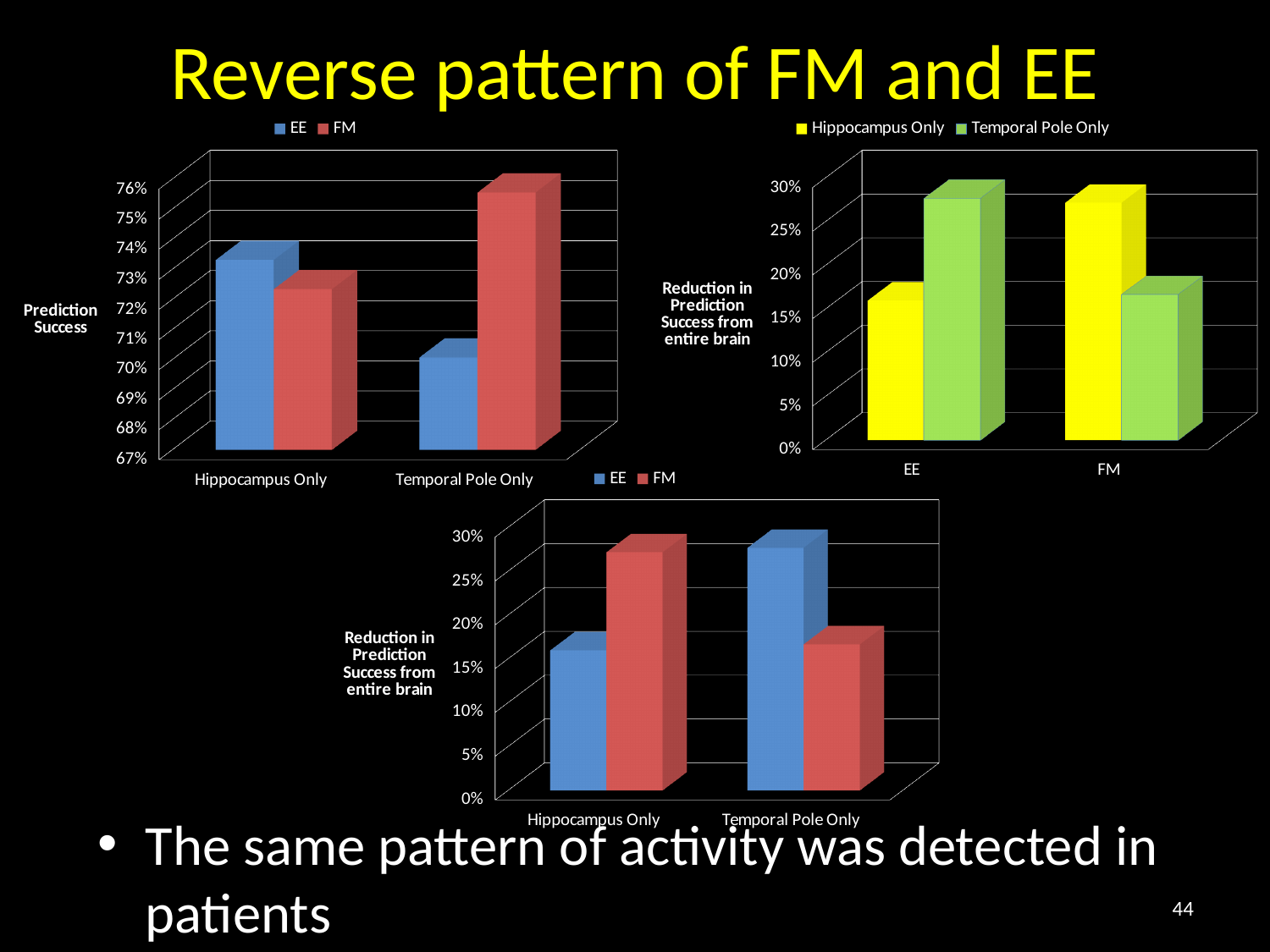
In the top-right chart, for EE, which series has the larger value, Hippocampus Only or Temporal Pole Only? Temporal Pole Only In the top-left chart, is the FM value for Temporal Pole Only greater or less than 74%? greater In the top-left chart, is the EE value for Temporal Pole Only greater or less than 72%? less In the bottom chart, is the FM value for Hippocampus Only greater or less than 20%? greater How many series does the legend of the top-left chart list? 2 How many categories are shown on the x axis of the bottom chart? 2 In the top-left chart, for Temporal Pole Only, which series has the larger value, EE or FM? FM In the bottom chart, for Hippocampus Only, which series has the larger value, EE or FM? FM What kind of chart is the top-left chart on the slide? bar chart Which series does the legend of the top-right chart list? Hippocampus Only, Temporal Pole Only